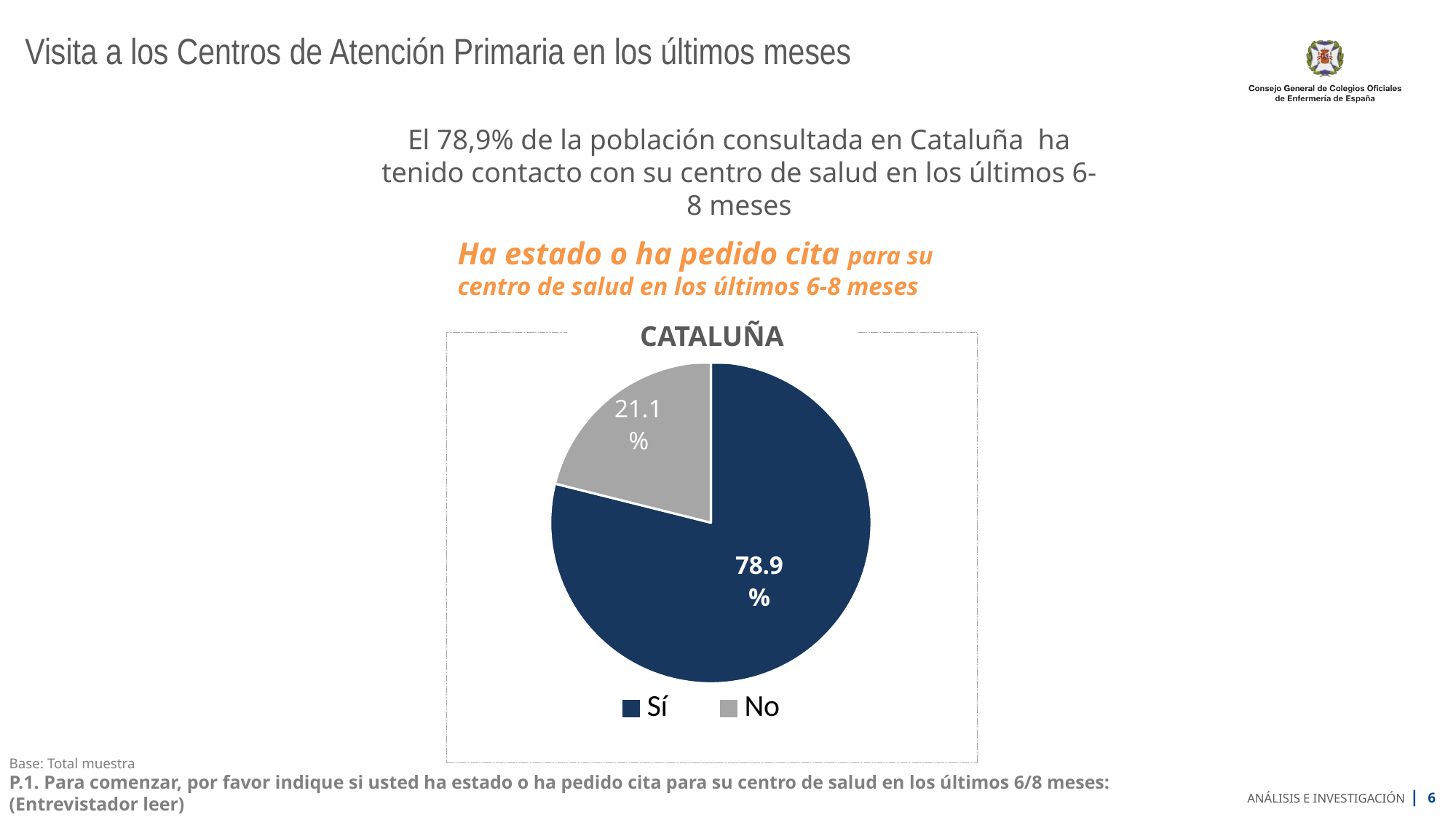
What colour is the "No" slice in the pie chart? Grey Which slice is the largest in the pie chart? Sí What percentage of the pie corresponds to "Sí"? 78.9% What share of the pie does the "Sí" slice represent? 78.9% How many entries does the legend list? 2 Which is larger, the "Sí" slice or the "No" slice? Sí What is the difference in percentage points between the "Sí" and "No" slices? 57.8 What percentage of the pie corresponds to "No"? 21.1% How many slices does the pie chart have? 2 What is the title of the chart? CATALUÑA Which slice is the smallest in the pie chart? No What type of chart is shown on the slide? Pie chart